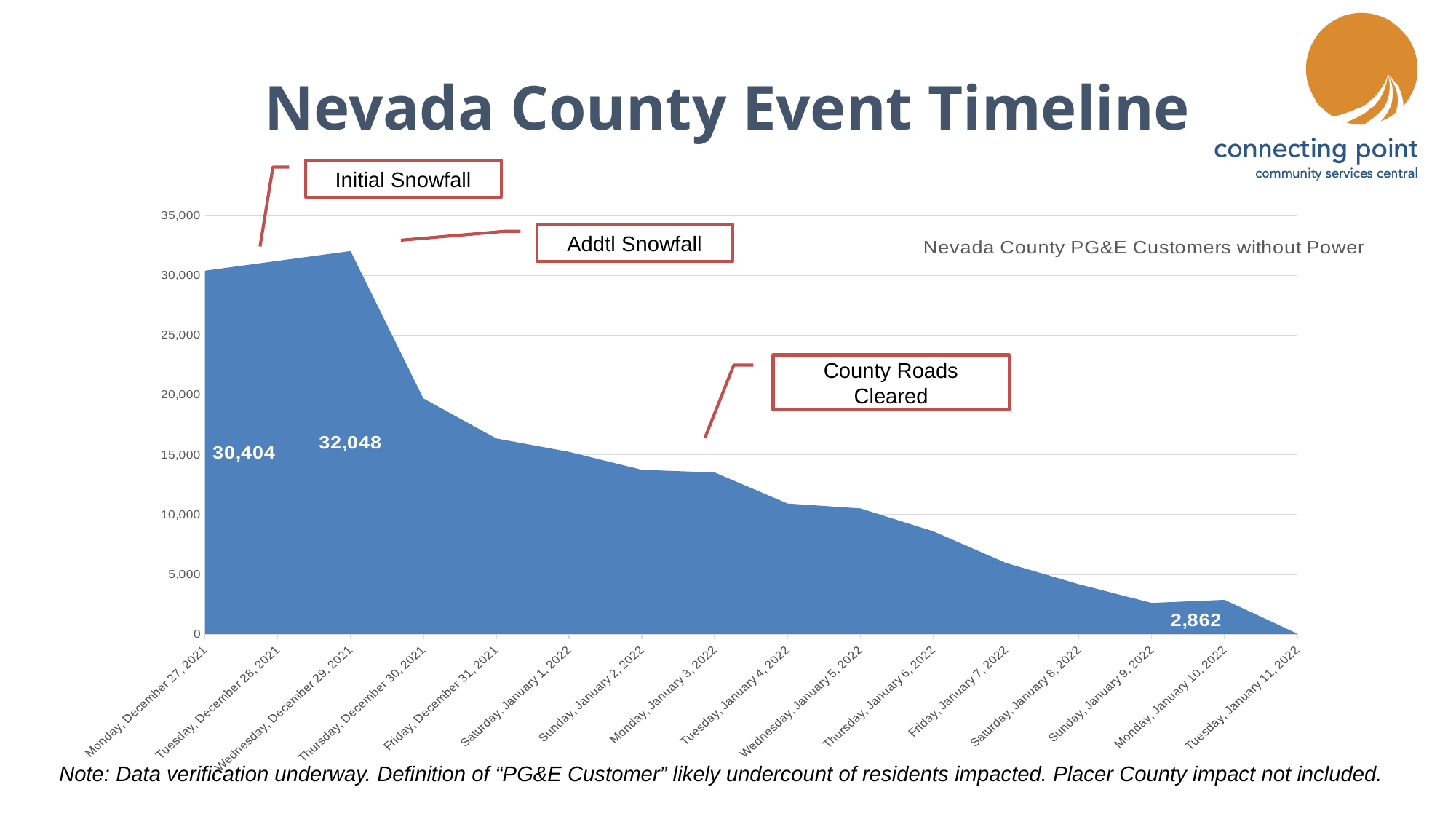
What is the name of the data series shown on the chart? Nevada County PG&E Customers without Power What is the peak number of customers without power shown on the chart? 32,048 On which date was the number of Nevada County PG&E customers without power highest? Wednesday, December 29, 2021 Is the value for Thursday, January 6, 2022 greater or less than 10,000? less After Wednesday, December 29, 2021, do the values rise or fall along the x axis? Fall Which date has the larger value: Friday, December 31, 2021 or Tuesday, January 4, 2022? Friday, December 31, 2021 What kind of chart is shown on the slide? Area chart How many dates are plotted along the x axis? 16 On which date was the number of customers without power lowest? Tuesday, January 11, 2022 What is the difference between the labelled values 32,048 and 30,404? 1,644 Is the value for Monday, January 3, 2022 greater or less than 15,000? less What value is labelled for Monday, January 10, 2022? 2,862